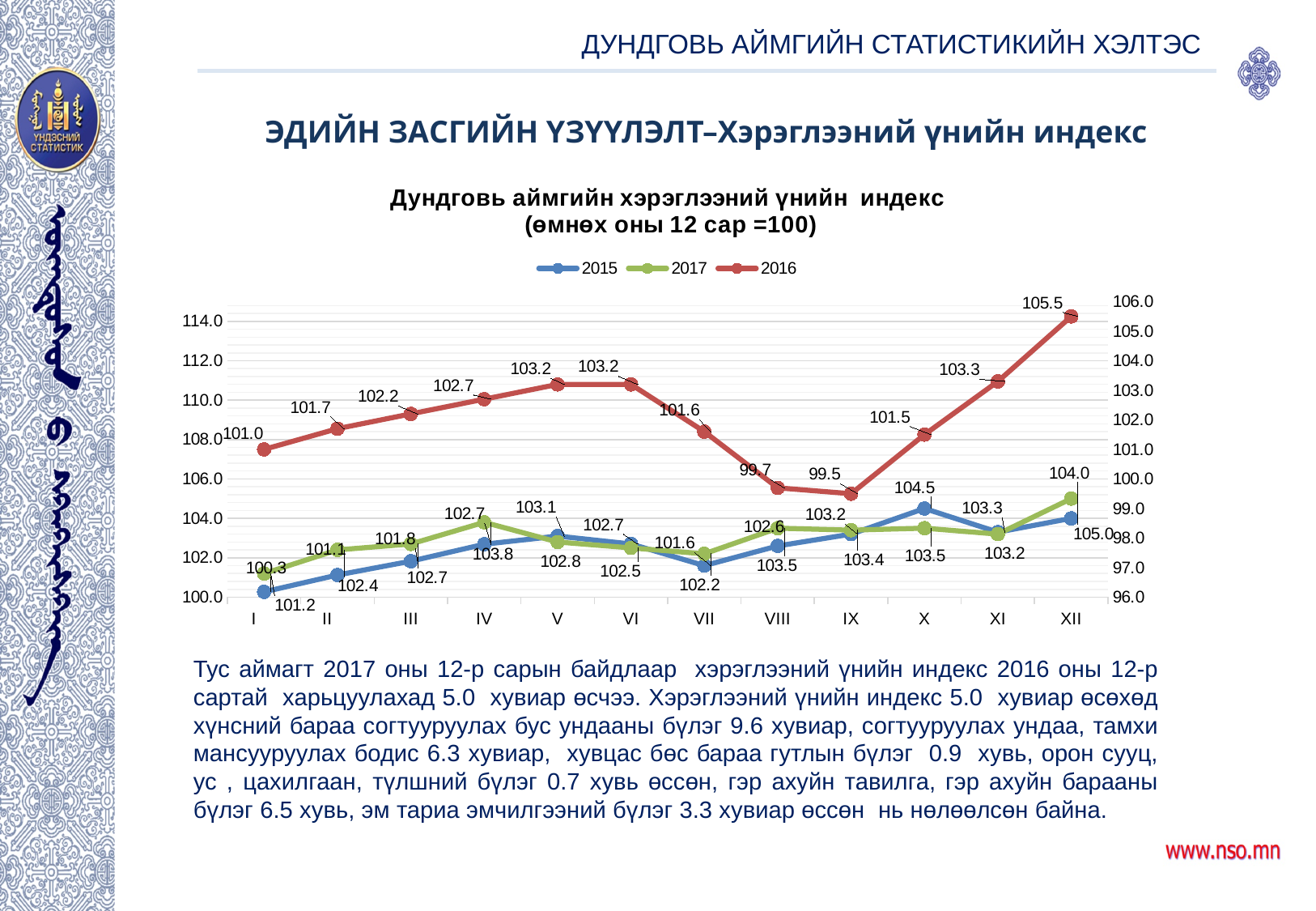
How many months (categories) are plotted along the x axis? 12 Which is larger for the 2016 series: the value in month V or in month VIII? month V In which month is the 2016 series at its highest? XII What is the value of the 2016 series in month VIII? 99.7 Does the 2016 series rise or fall from month VI to month IX? fall What is the difference between the 2016 values in month XII and month I? 4.5 In which month is the 2016 series at its lowest? IX What kind of chart is shown on the slide? line chart What is the value of the 2016 series in month XII? 105.5 How many series does the legend list? 3 What is the value of the 2016 series in month I? 101.0 What colour is the 2016 series line in the legend? red